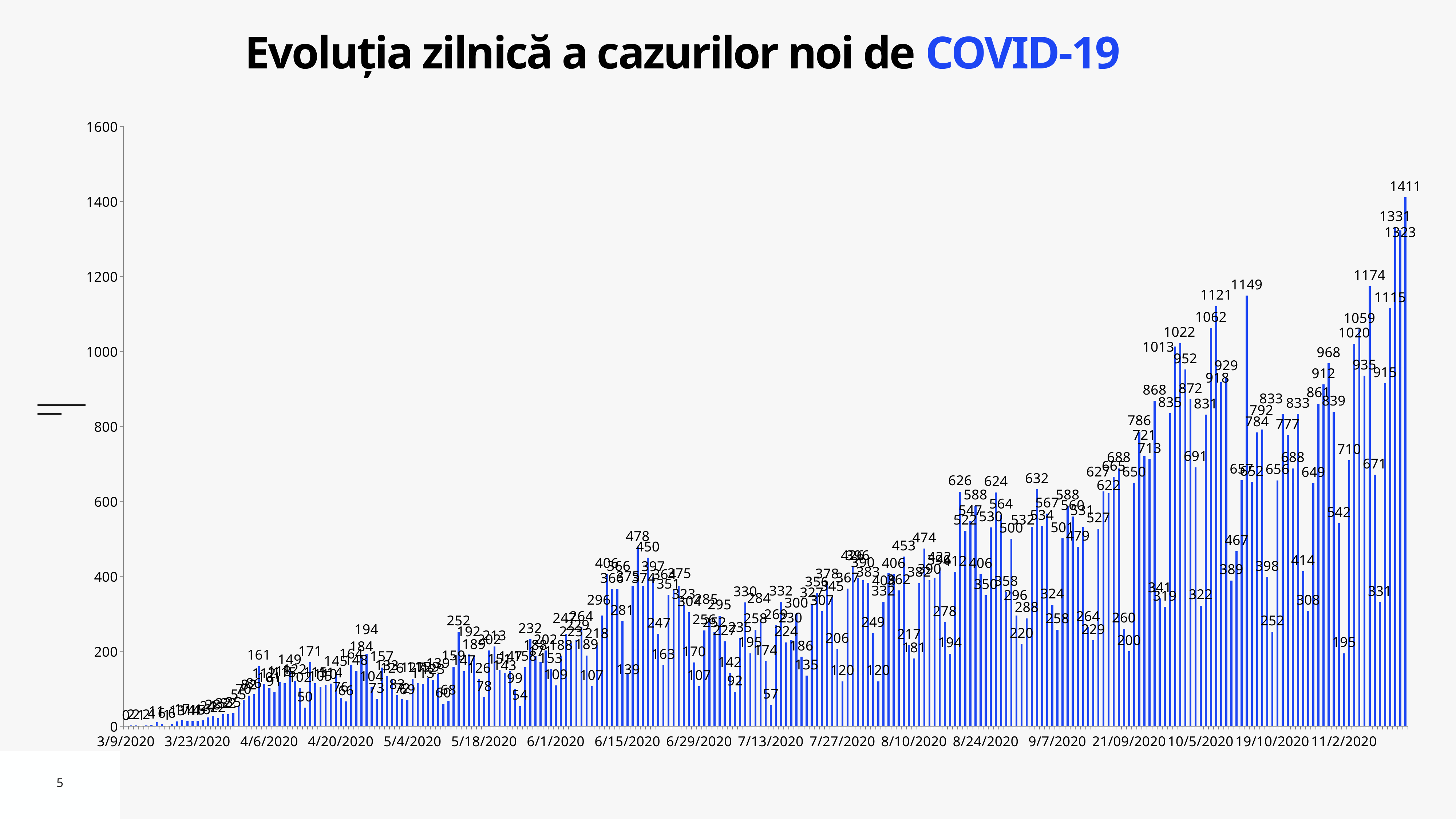
What type of chart is shown on the slide? bar chart Is the highest value in the chart greater or less than 1400? greater Is the value of the last bar in the chart greater or less than 1200? greater What is the highest tick value shown on the y axis? 1600 What is the difference between the highest value (1411) and the second highest value (1331)? 80 Do the daily values generally rise or fall from left to right along the x axis? rise What is the title of the chart? Evoluția zilnică a cazurilor noi de COVID-19 What is the highest daily value shown in the chart? 1411 What is the first date label shown on the x axis? 3/9/2020